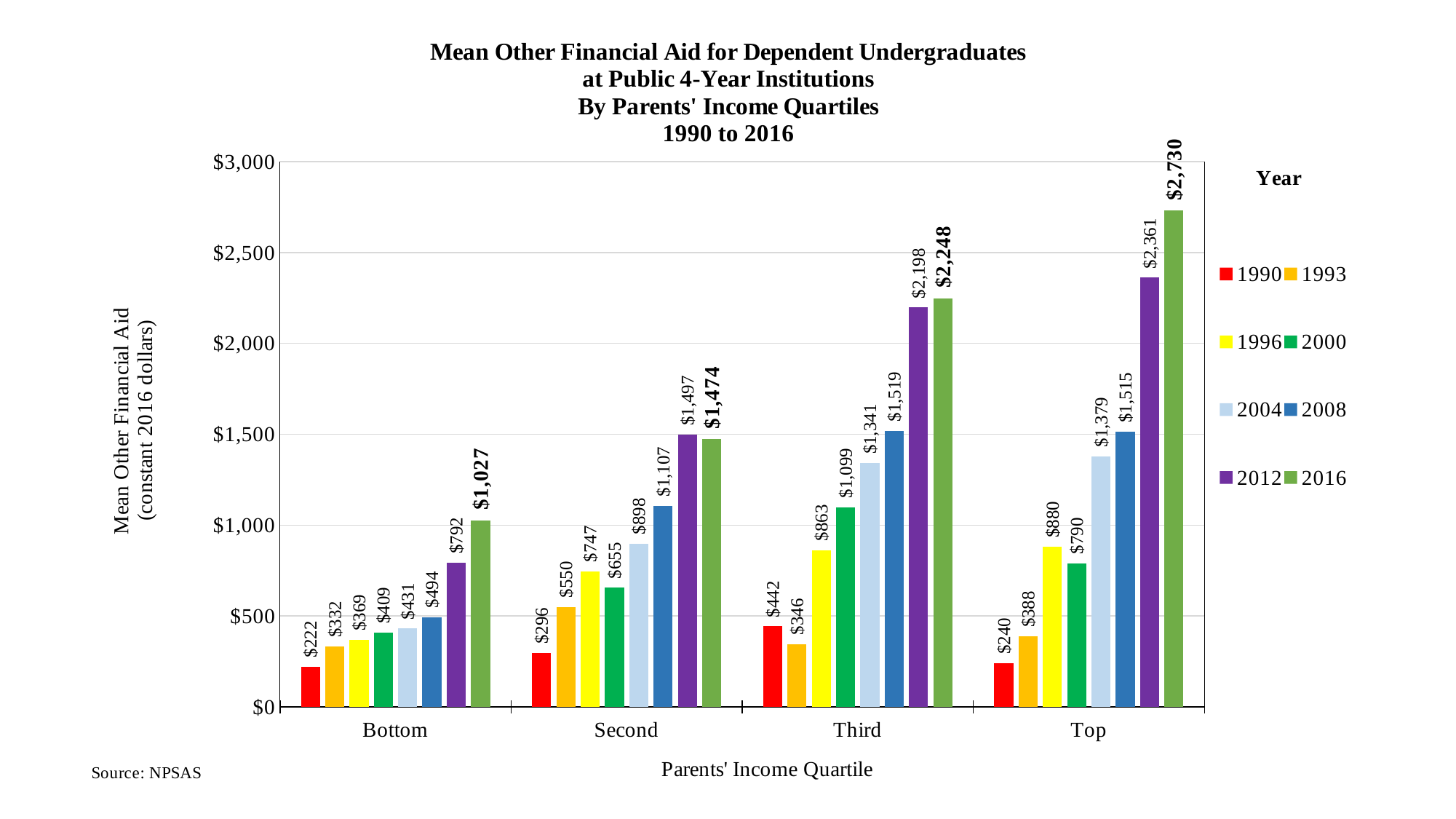
What is the mean other financial aid for the Third quartile in 2008? $1,519 Which income quartile has the lowest mean other financial aid in 1990? Bottom Which is larger for the Second quartile: the 2012 value or the 2016 value? 2012 What is the mean other financial aid for the Top quartile in 1990? $240 How many income quartile categories are shown on the x axis? 4 For the Bottom quartile, do the values rise or fall from 1990 to 2016? Rise What is the difference between the 2016 and 2012 values for the Top quartile? $369 What is the source cited for the chart? NPSAS What kind of chart is shown on the slide? Bar chart What is the mean other financial aid for the Bottom quartile in 2016? $1,027 Which income quartile has the highest mean other financial aid in 2016? Top How many years does the legend list? 8